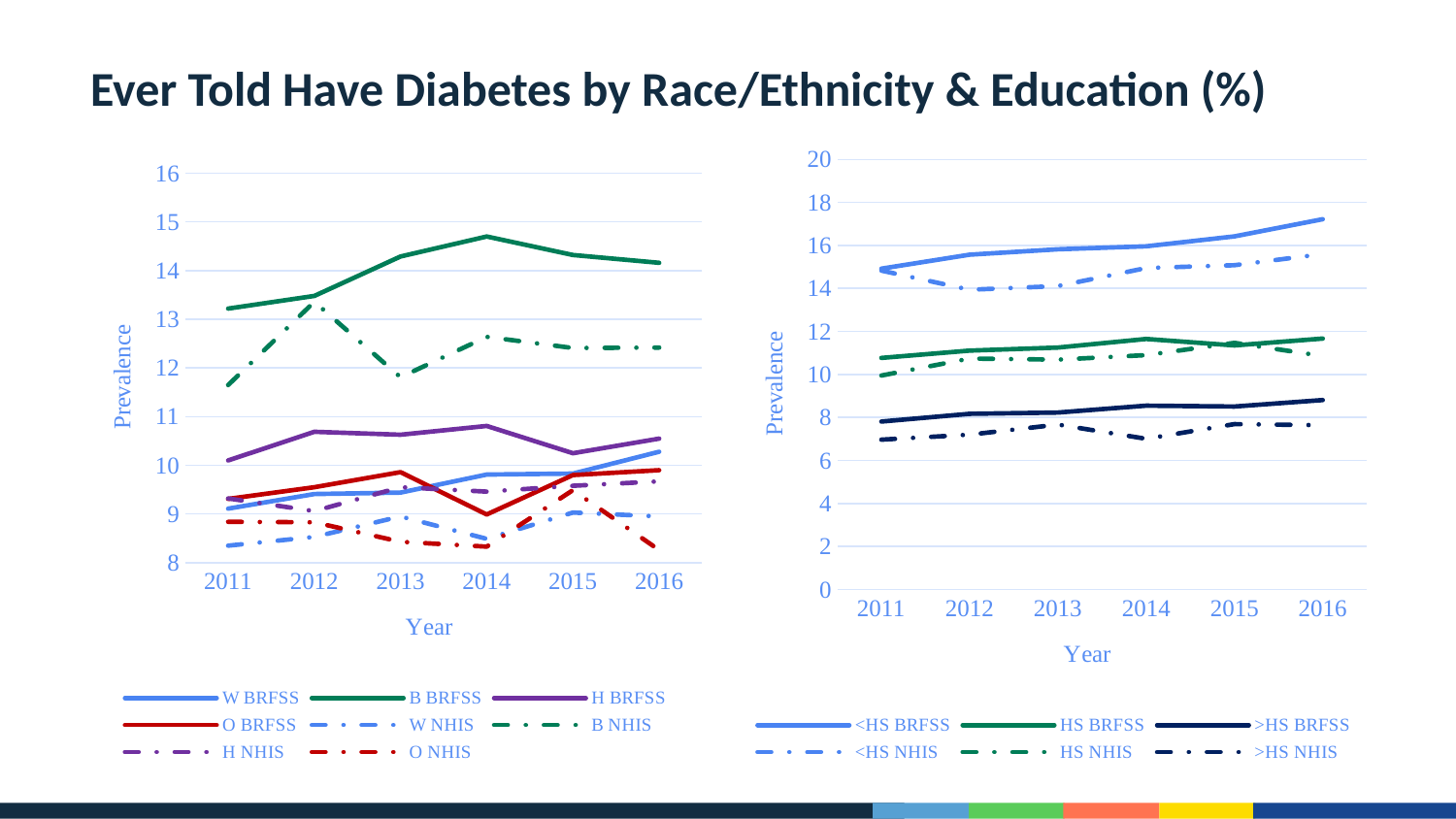
What is the label on the y axis of the right chart? Prevalence In the left chart, which series has the highest values across all years? B BRFSS How many years are plotted along the x axis of the right chart? 6 How many series does the legend of the right chart (education) list? 6 What kind of chart is the left chart on the slide? line chart How many series does the legend of the left chart (race/ethnicity) list? 8 In the left chart, which is larger in 2013: B BRFSS or W BRFSS? B BRFSS In the right chart, is the value for <HS BRFSS in 2016 greater or less than 16? greater In the right chart, which series has the highest values across all years? <HS BRFSS In the right chart, does the <HS BRFSS line rise or fall from 2011 to 2016? rise In the left chart, is the value for B BRFSS in 2014 greater or less than 14? greater